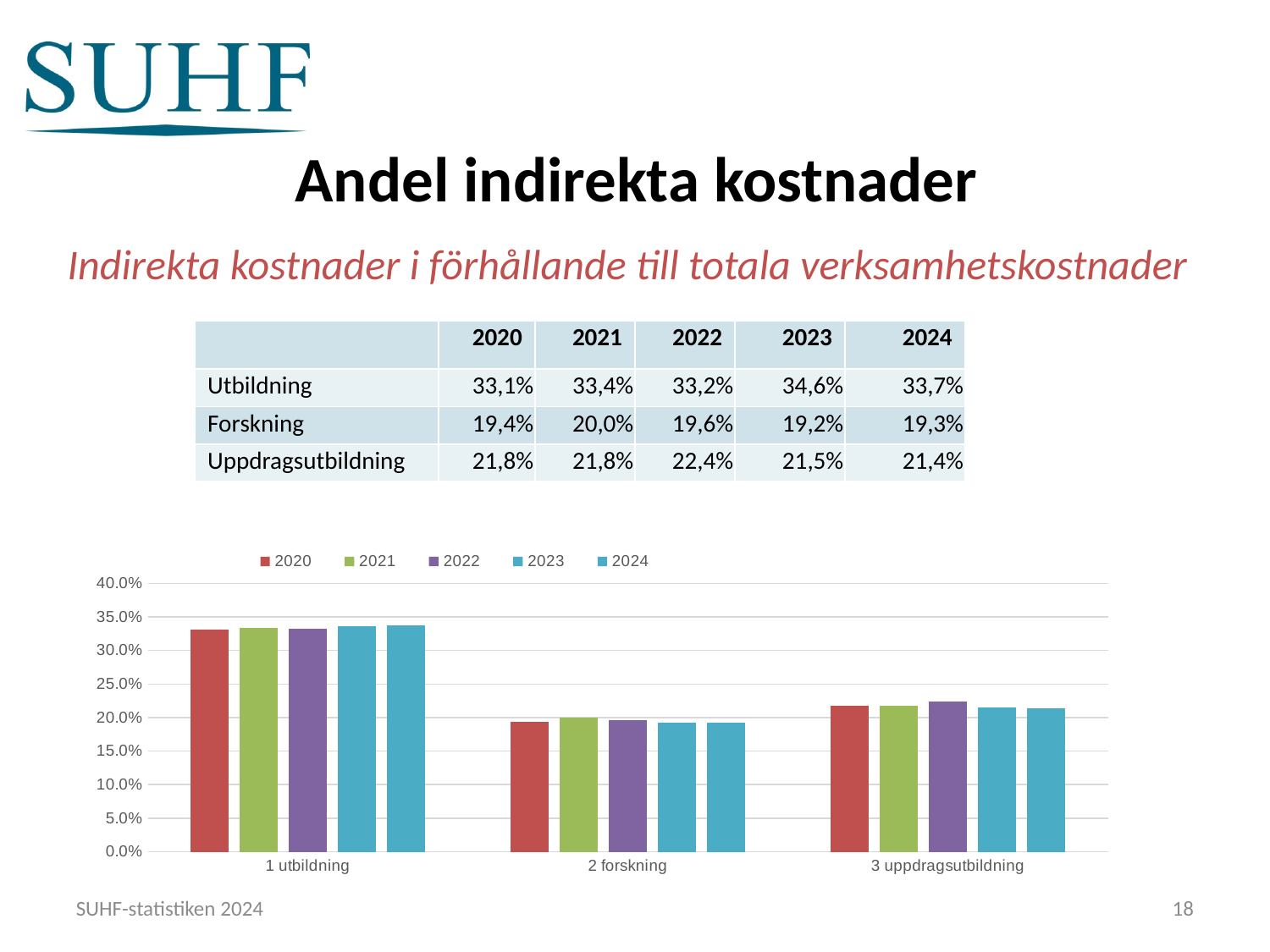
How many series does the chart legend list? 5 How many categories are shown along the x axis of the chart? 3 Which category has the lowest bars in the chart? 2 forskning Is the value for forskning in 2024 greater or less than 25.0%? less Which category has the highest bars in the chart? 1 utbildning Which is larger for Utbildning, the value for 2023 or the value for 2024? 2023 What is the value for Uppdragsutbildning in 2022? 22,4% What kind of chart is shown on the slide? Bar chart What colour represents the 2020 series in the chart legend? Red What is the value for Forskning in 2021? 20,0% Is the value for utbildning in 2020 greater or less than 30.0%? greater What is the value for Utbildning in 2023? 34,6%